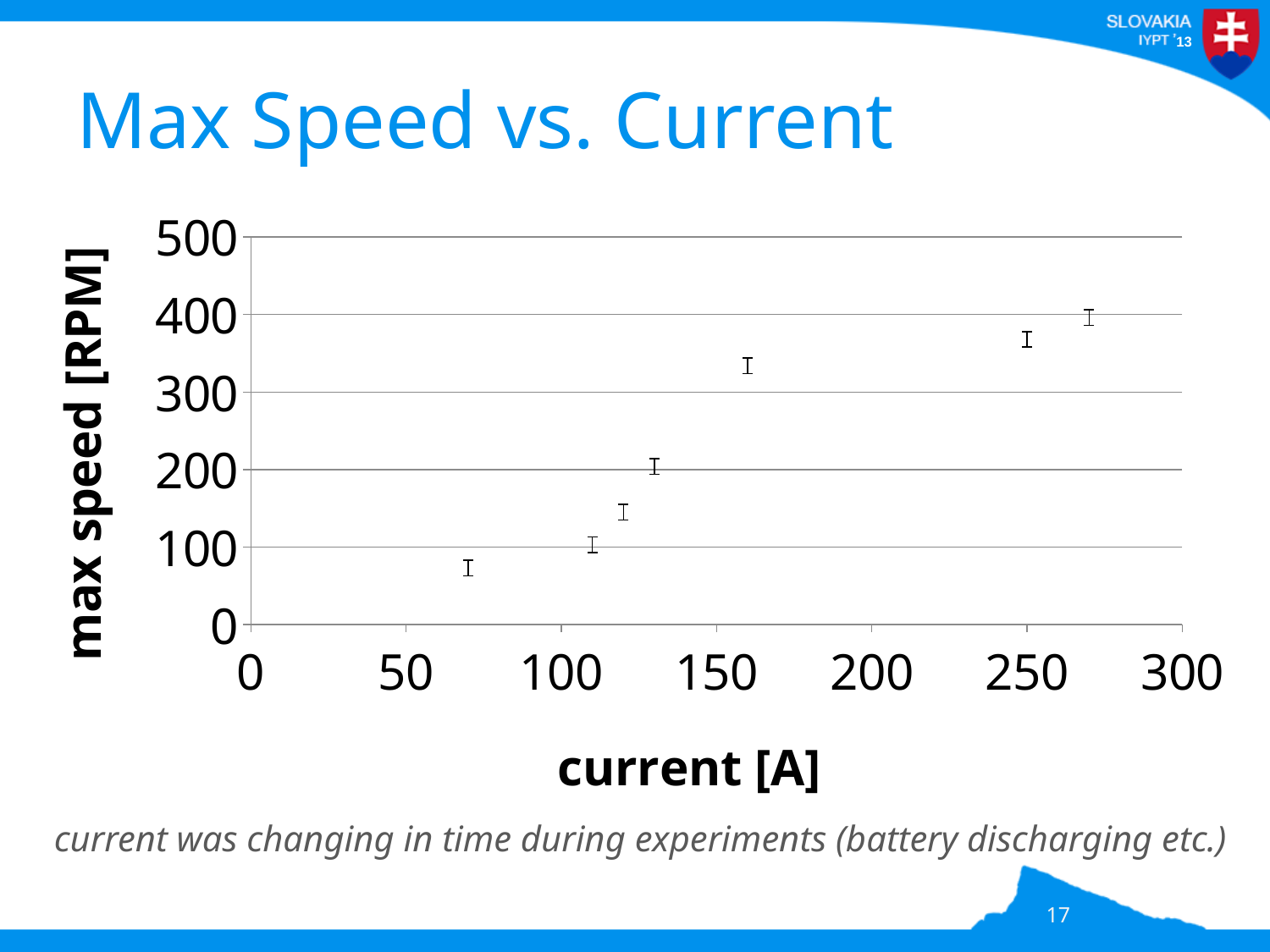
Which has the higher max speed: the point near 160 A or the point near 250 A? the point near 250 A Does the max speed rise or fall as the current increases along the x axis? rise Is the highest max speed reached at the lowest or the highest current plotted? the highest current Is the max speed for the point near 160 A greater or less than 400 RPM? less What is the label of the y axis? max speed [RPM] How many data points are plotted on the chart? 7 Is the max speed for the point near 160 A greater or less than 300 RPM? greater What kind of chart is shown on the slide? scatter chart What is the title of the chart? Max Speed vs. Current Is the max speed for the point near 70 A greater or less than 100 RPM? less